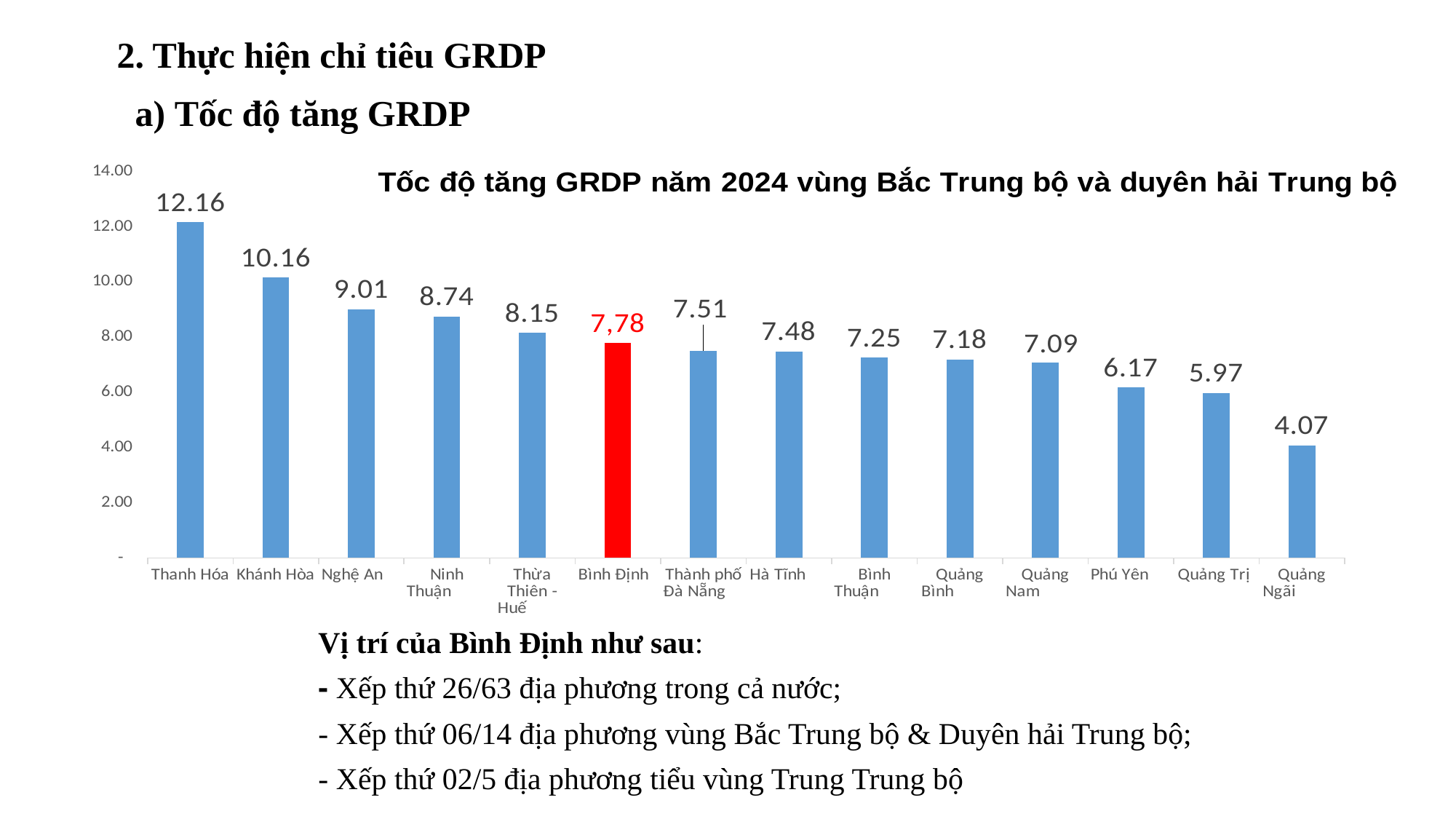
Which has a higher value, Nghệ An or Ninh Thuận? Nghệ An Which locality has the highest GRDP growth rate in the chart? Thanh Hóa How many localities are shown in the chart? 14 What is the difference between the values for Phú Yên and Quảng Trị? 0.20 Which locality has the lowest GRDP growth rate in the chart? Quảng Ngãi Which bar in the chart is coloured red? Bình Định Is the value for Khánh Hòa greater or less than 10.00? greater What is the difference between the values for Thanh Hóa and Khánh Hòa? 2.00 What kind of chart is shown on the slide? Bar chart What is the GRDP growth rate shown for Thanh Hóa? 12.16 What value is labelled on the bar for Bình Định? 7,78 What is the value shown for Quảng Ngãi? 4.07